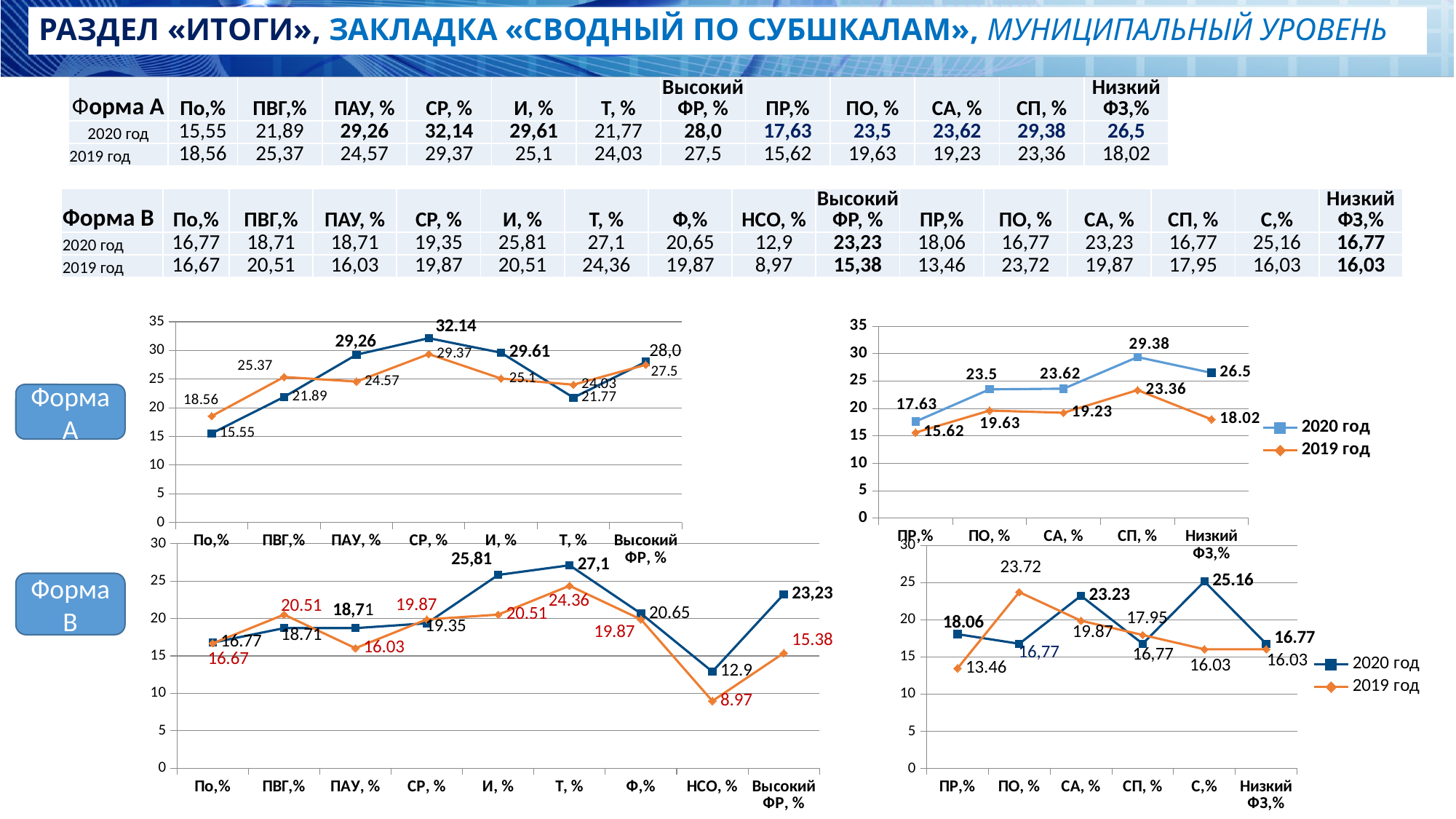
In the top-right chart (Форма A), what is the 2019 год value for СП, %? 23.36 In the bottom-left chart (Форма B), which category has the lowest 2019 год value? НСО, % In the top-left chart (Форма A), which category has the highest 2020 год value? СР, % What kind of chart is the top-right chart (Форма A)? line chart In the top-right chart (Форма A), how many series does the legend list? 2 In the top-left chart (Форма A), what is the 2020 год value for СР, %? 32.14 In the bottom-left chart (Форма B), how many categories are shown on the x axis? 9 In the bottom-left chart (Форма B), what is the difference between the 2020 год and 2019 год values for НСО, %? 3.93 In the top-left chart (Форма A), what is the difference between the 2019 год and 2020 год values for По,%? 3.01 In the bottom-right chart (Форма B), what is the 2019 год value for ПО, %? 23.72 In the top-right chart (Форма A), does the 2020 год series rise or fall from ПР,% to СП, %? rises In the bottom-right chart (Форма B), which series has the larger value for СА, %: 2020 год or 2019 год? 2020 год